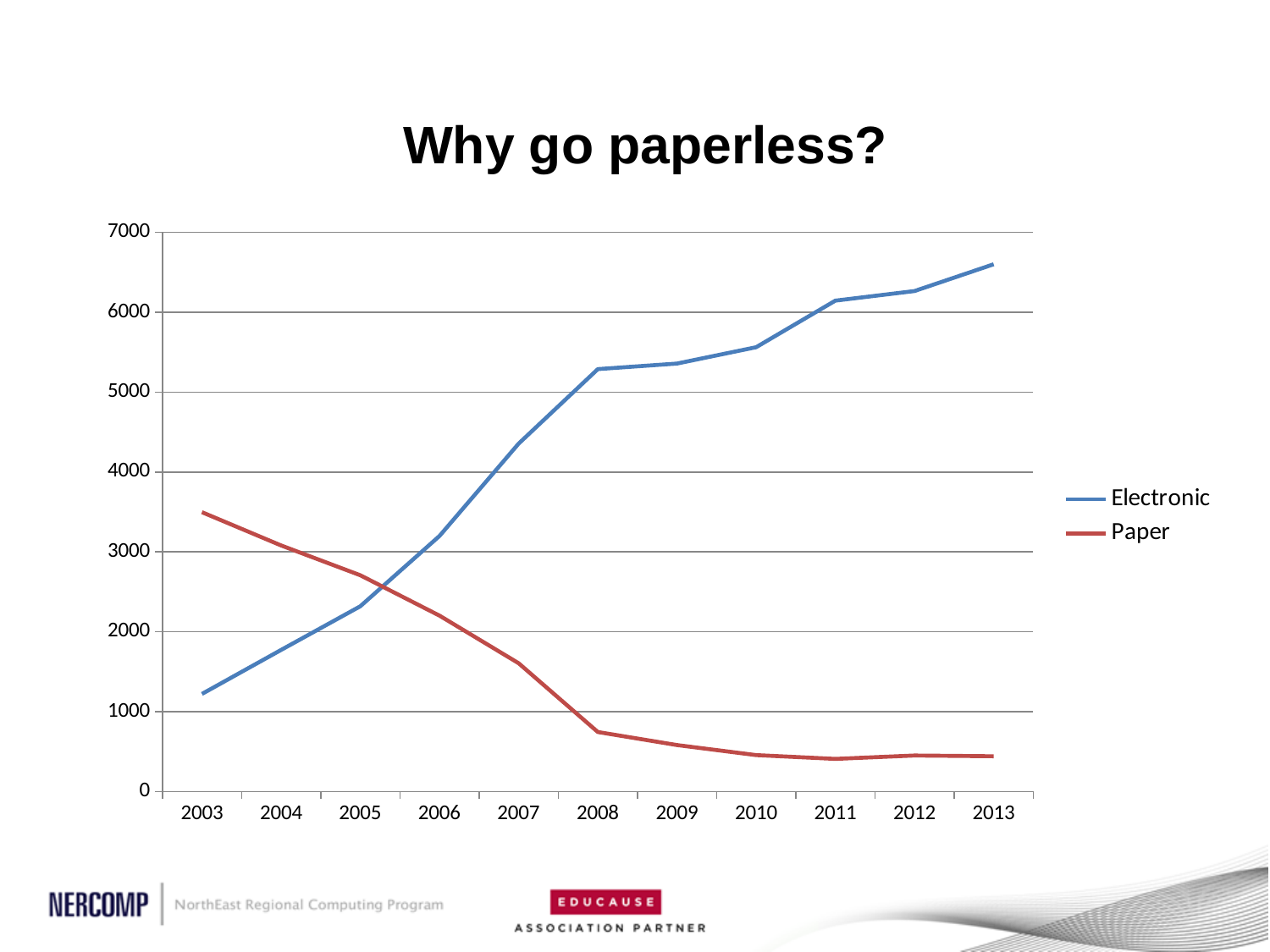
Does the Electronic series rise or fall from 2003 to 2013? rise How many series does the legend list? 2 Is the value for Paper in 2003 greater or less than 3000? greater Is the value for Paper in 2008 greater or less than 1000? less In which year is the Electronic series at its highest? 2013 In 2003, which series has the larger value, Electronic or Paper? Paper What is the title of the slide containing the chart? Why go paperless? In 2013, which series has the larger value, Electronic or Paper? Electronic Is the value for Electronic in 2013 greater or less than 6000? greater How many years are shown on the x axis? 11 Does the Paper series rise or fall from 2003 to 2013? fall What kind of chart is shown on the slide? line chart